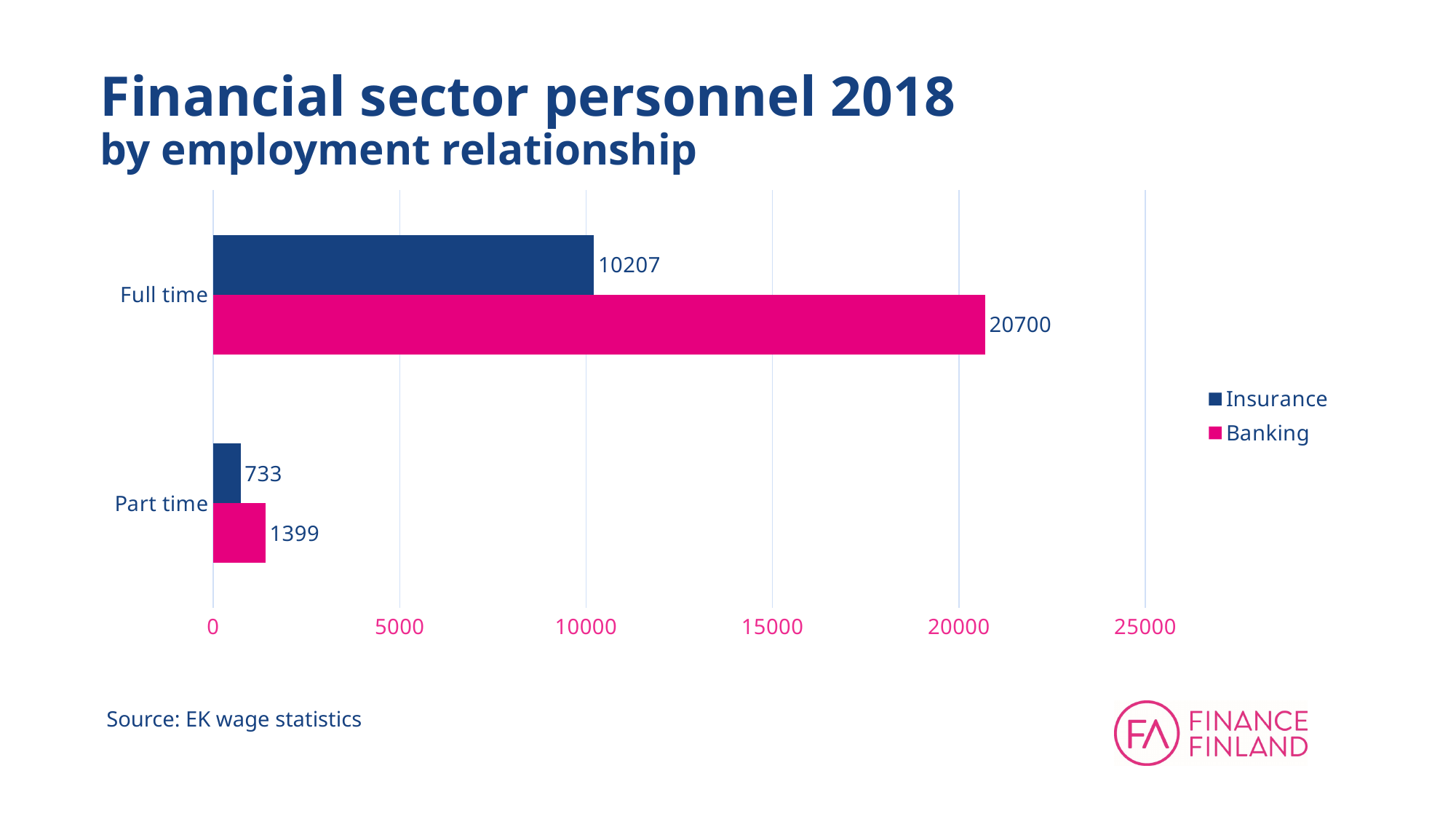
What kind of chart is shown on the slide? Bar chart What is the difference between Banking and Insurance in the Full time category? 10493 What is the value for Banking in the Part time category? 1399 What is the value for Banking in the Full time category? 20700 What is the difference between Banking and Insurance in the Part time category? 666 Which bar has the lowest value on the chart? Insurance, Part time How many series does the legend list? 2 Which is larger: Insurance Full time or Banking Part time? Insurance Full time What is the value for Insurance in the Part time category? 733 What is the value for Insurance in the Full time category? 10207 Which series has the highest value in the Full time category? Banking How many categories are shown on the chart? 2